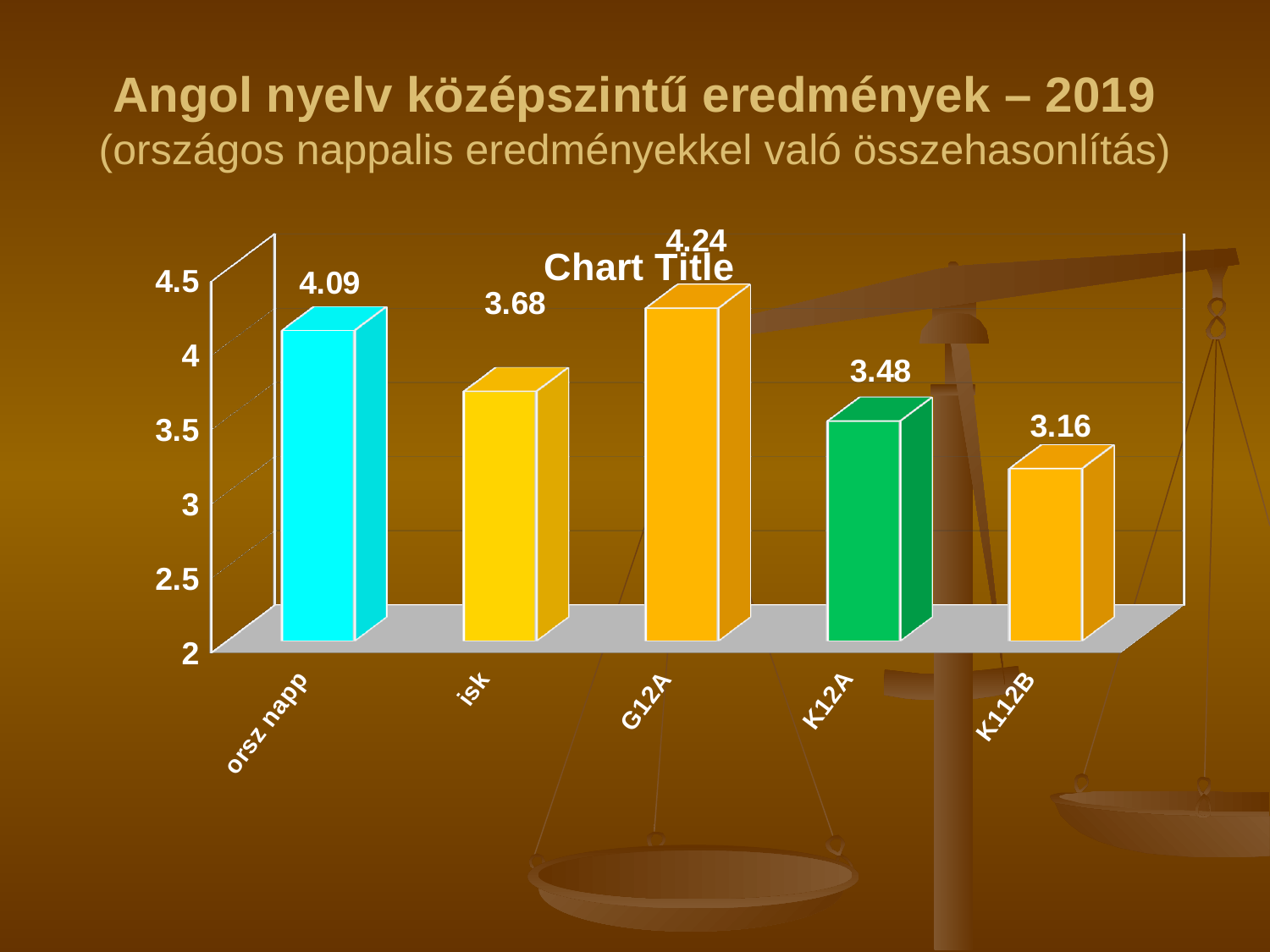
What is the value for K12A? 3.48 How many categories are shown on the chart? 5 Which is larger, the value for isk or the value for K12A? isk What is the value for orsz napp? 4.09 Which category has the highest value? G12A What title is printed on the chart itself? Chart Title What is the difference between the values for G12A and orsz napp? 0.15 What is the value for isk? 3.68 What is the value for G12A? 4.24 Which category has the lowest value? K112B What is the value for K112B? 3.16 What kind of chart is shown on the slide? bar chart